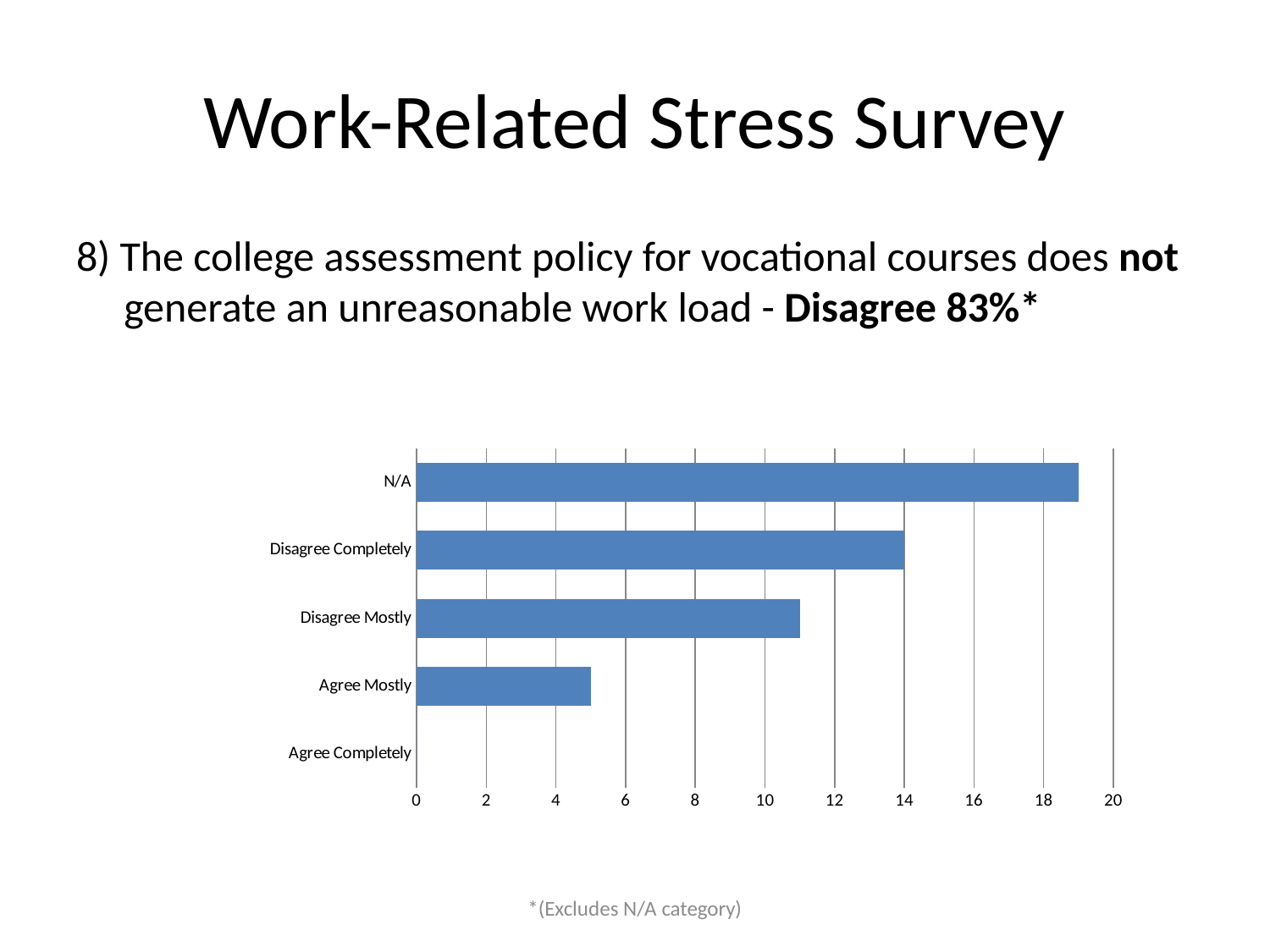
Is the value for N/A greater or less than 18? greater Which is larger, the value for Disagree Mostly or the value for Agree Mostly? Disagree Mostly What is the value for Disagree Completely? 14 What is the value for Agree Completely? 0 Is the value for Disagree Mostly greater or less than 10? greater Which category has the highest value? N/A Is the value for Agree Mostly greater or less than 6? less Which is larger, the value for Disagree Completely or the value for N/A? N/A What is the maximum value shown on the horizontal axis? 20 How many categories are shown on the chart? 5 What kind of chart is shown on the slide? bar chart Which category has the lowest value? Agree Completely